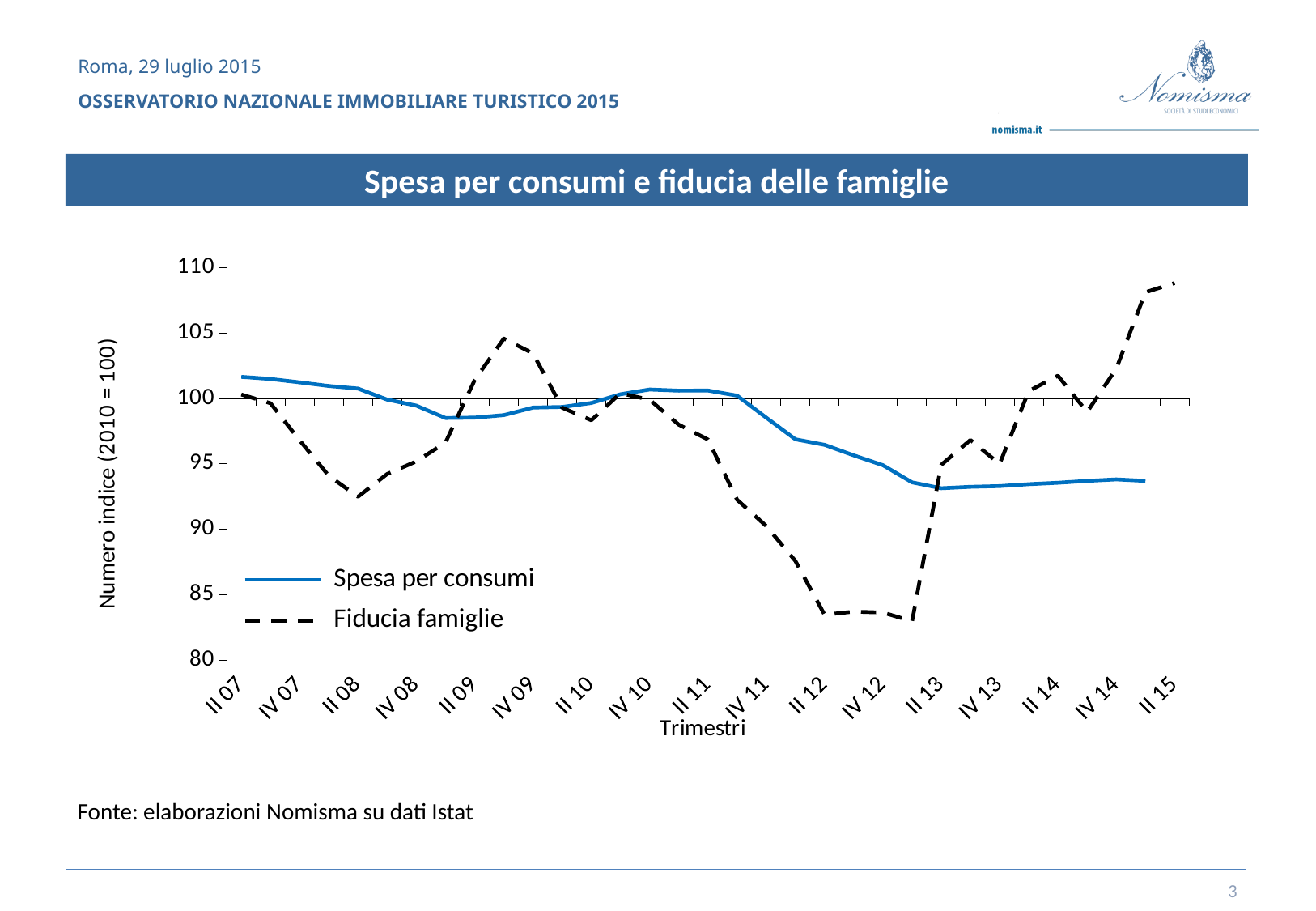
What is the label of the y axis? Numero indice (2010 = 100) What kind of chart is shown on the slide? Line chart At II 12, which series has the higher value, Spesa per consumi or Fiducia famiglie? Spesa per consumi Is the value of Fiducia famiglie at II 15 greater or less than 105? greater How many series does the legend list? 2 Is the value of Fiducia famiglie at II 12 greater or less than 85? less How many quarter labels are shown on the x axis? 17 Does Spesa per consumi rise or fall between IV 10 and II 13? Fall What is the title of the chart? Spesa per consumi e fiducia delle famiglie Is the value of Spesa per consumi at II 13 greater or less than 95? less At which quarter does Fiducia famiglie reach its highest value? II 15